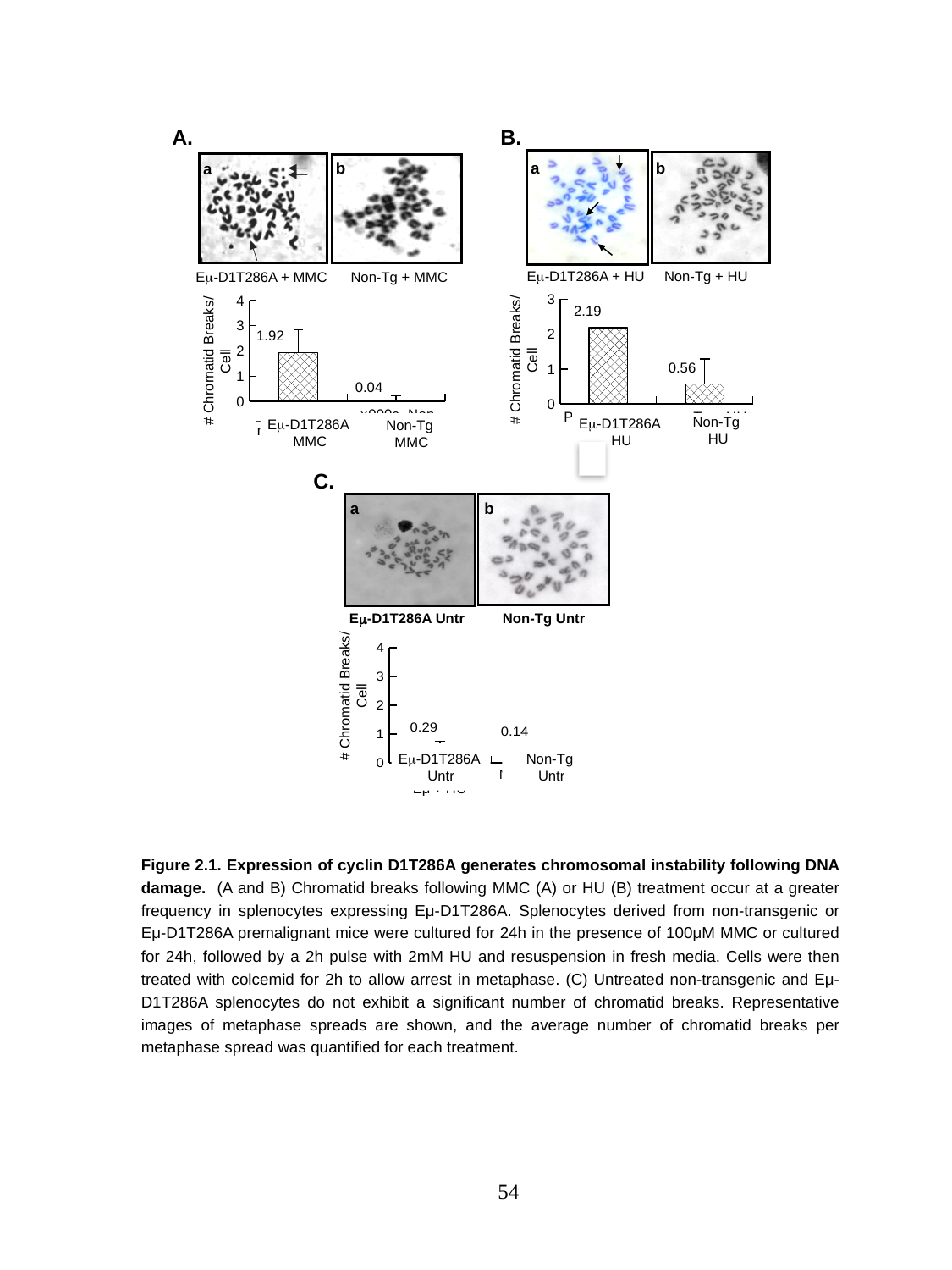
In the chart in panel B, what is the number of chromatid breaks per cell for Eμ-D1T286A HU? 2.19 In the chart in panel A, which category has the higher number of chromatid breaks per cell? Eμ-D1T286A MMC In the chart in panel B, what is the number of chromatid breaks per cell for Non-Tg HU? 0.56 In the chart in panel B, what is the difference in chromatid breaks per cell between Eμ-D1T286A HU and Non-Tg HU? 1.63 In the chart in panel A, what is the number of chromatid breaks per cell for Eμ-D1T286A MMC? 1.92 In the chart in panel A, what is the number of chromatid breaks per cell for Non-Tg MMC? 0.04 In the chart in panel A, what is the difference in chromatid breaks per cell between Eμ-D1T286A MMC and Non-Tg MMC? 1.88 In the chart in panel C, which category has the lower number of chromatid breaks per cell? Non-Tg Untr What type of chart is shown in panel B? bar chart In the chart in panel C, what is the number of chromatid breaks per cell for Eμ-D1T286A Untr? 0.29 What is the y-axis label of the chart in panel C? # Chromatid Breaks/ Cell In the chart in panel C, what is the number of chromatid breaks per cell for Non-Tg Untr? 0.14